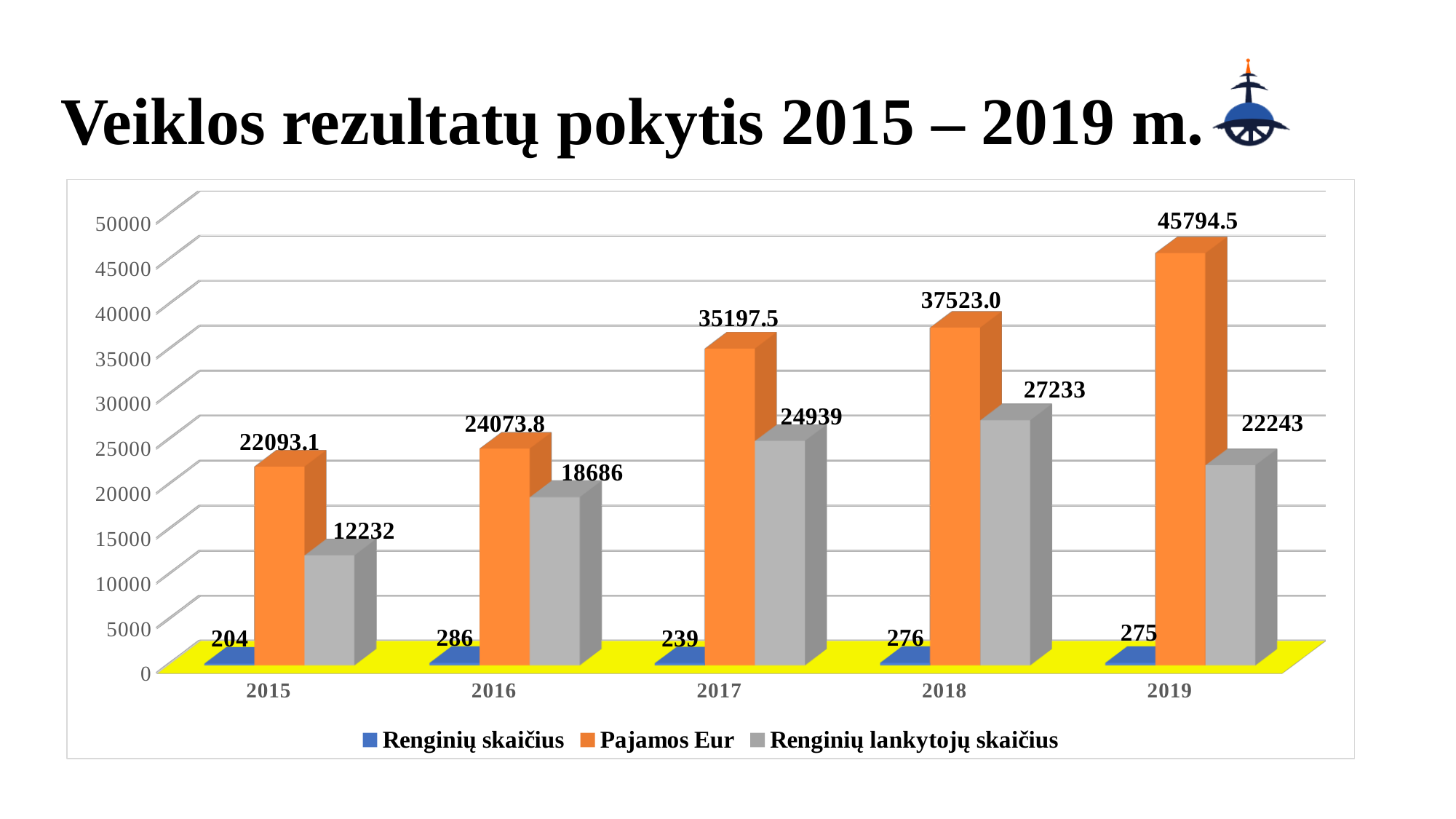
In which year is Renginių lankytojų skaičius lowest? 2015 Which is larger: Renginių lankytojų skaičius in 2017 or in 2019? 2017 What colour are the Pajamos Eur bars? orange What is the value of Renginių skaičius for 2016? 286 How many years are shown on the x axis? 5 What is the value of Renginių lankytojų skaičius for 2018? 27233 What is the value of Pajamos Eur for 2017? 35197.5 What is the difference between Pajamos Eur in 2019 and in 2018? 8271.5 In which year is Pajamos Eur highest? 2019 Does Pajamos Eur rise or fall from 2015 to 2019? rise What kind of chart is shown on the slide? bar chart How many series does the legend list? 3